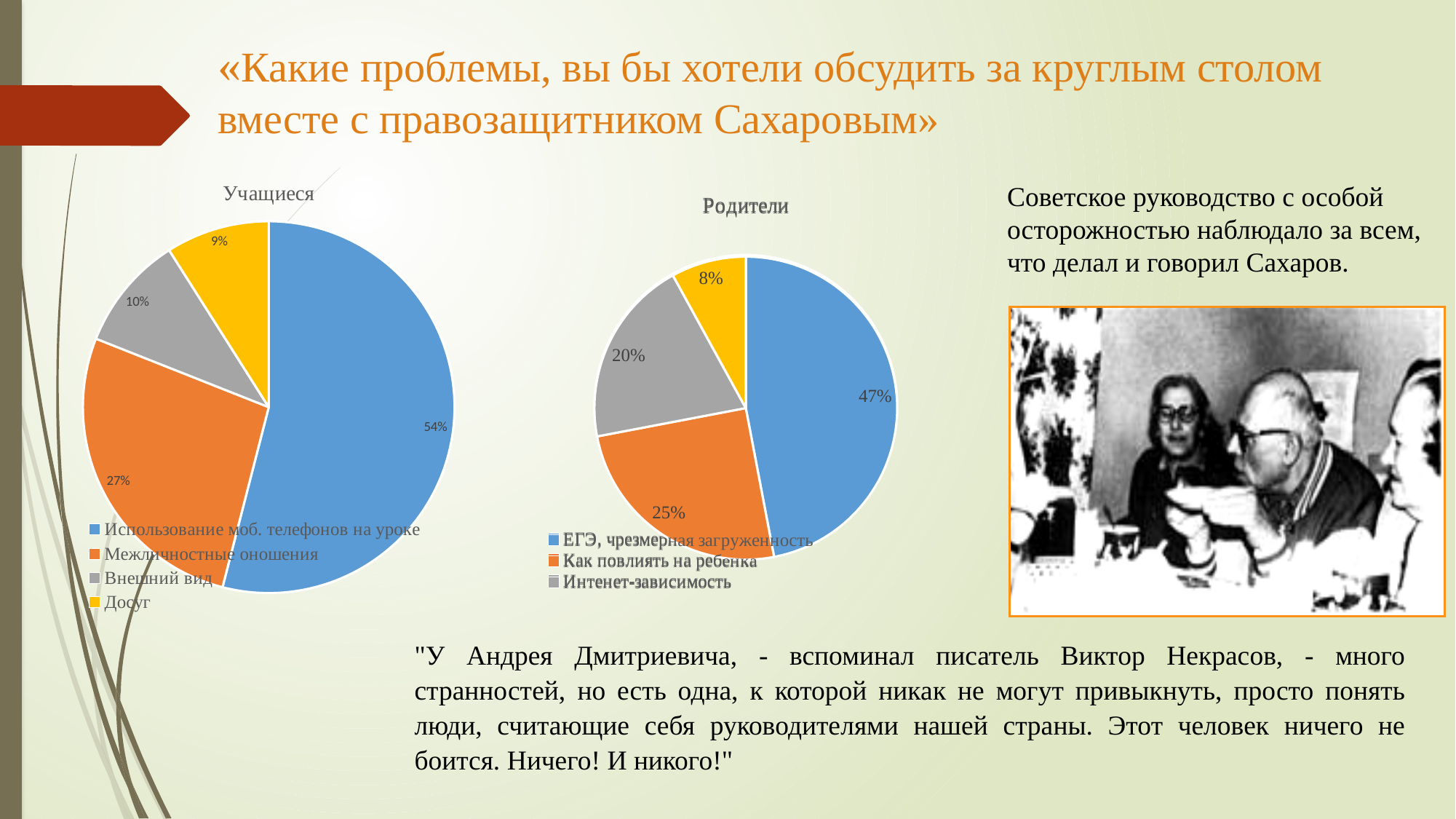
In the "Родители" chart, what is the difference between "Как повлиять на ребенка" and "Интенет-зависимость"? 5% In the "Родители" chart, which category has the largest slice? ЕГЭ, чрезмерная загруженность How many entries does the legend of the "Родители" chart list? 3 In the "Учащиеся" chart, what share does "Использование моб. телефонов на уроке" have? 54% In the "Учащиеся" chart, what is the value for "Межличностные оношения"? 27% In the "Учащиеся" chart, what is the value for "Досуг"? 9% In the "Родители" chart, what share does "ЕГЭ, чрезмерная загруженность" have? 47% In the "Учащиеся" chart, what is the difference between "Использование моб. телефонов на уроке" and "Межличностные оношения"? 27% In the "Родители" chart, what is the value for "Интенет-зависимость"? 20% In the "Учащиеся" chart, which category has the smallest slice? Досуг What type of chart is the "Учащиеся" chart? Pie chart In the "Родители" chart, which is larger: "Как повлиять на ребенка" or "Интенет-зависимость"? Как повлиять на ребенка